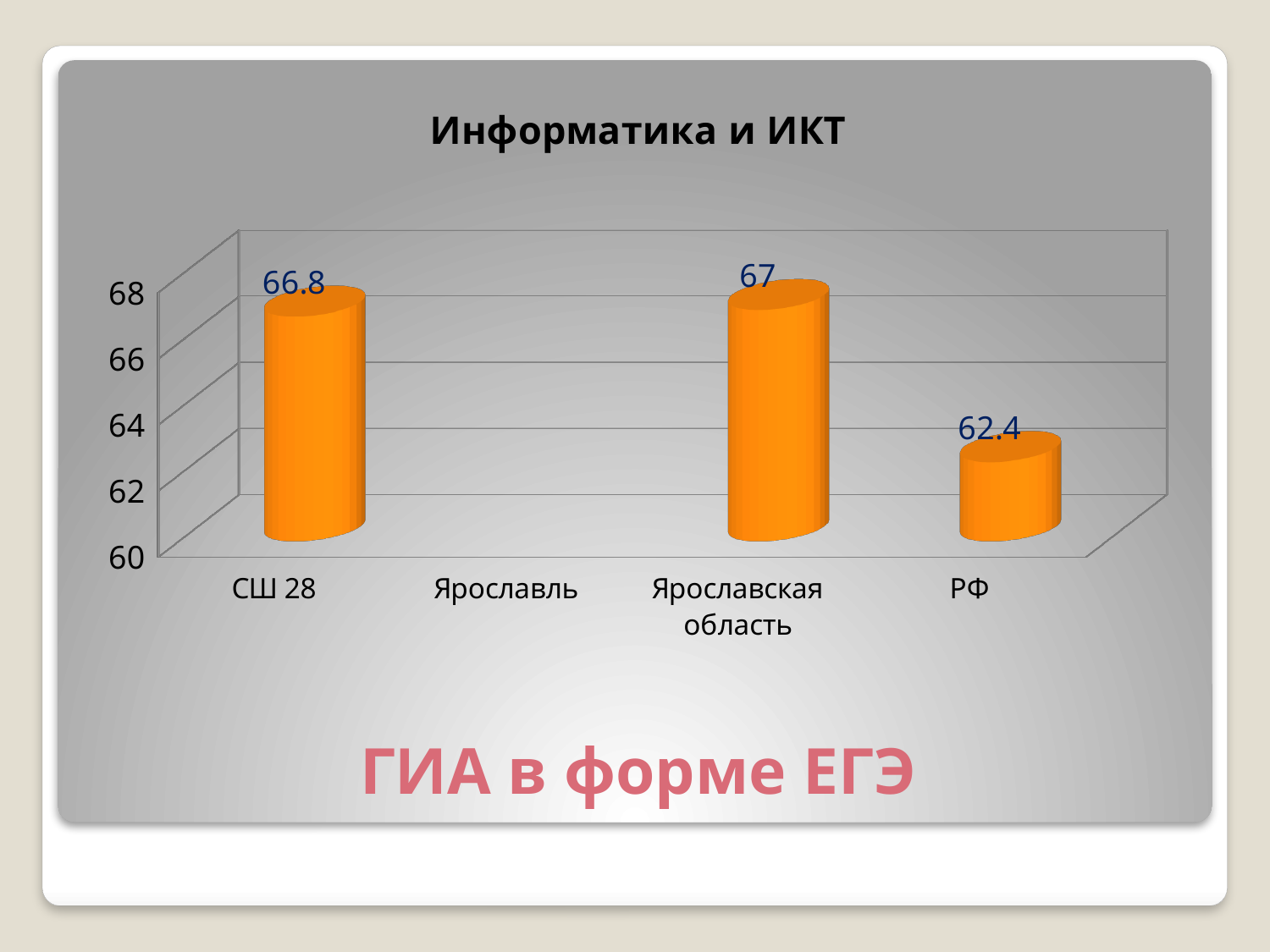
Which is larger, the value for СШ 28 or the value for РФ? СШ 28 Which category with a plotted bar has the lowest value? РФ What is the difference between the values for СШ 28 and РФ? 4.4 What is the value for СШ 28? 66.8 What is the title of the chart? Информатика и ИКТ Which category has the highest value? Ярославская область What is the difference between the values for Ярославская область and РФ? 4.6 What is the value for Ярославская область? 67 What is the value for РФ? 62.4 What kind of chart is shown on the slide? bar chart Is the value for РФ greater or less than 64? less How many categories are labelled on the x axis? 4